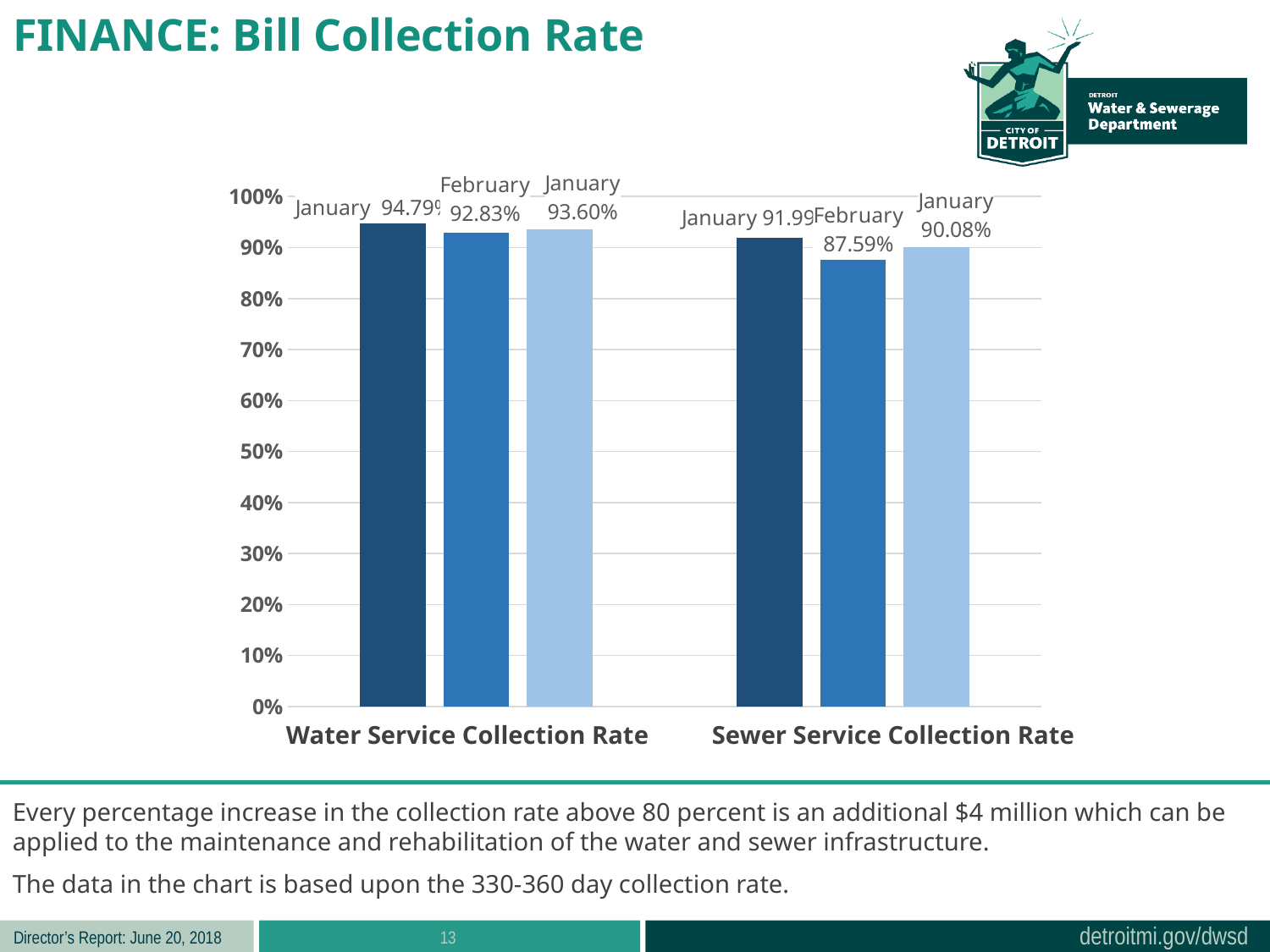
Is the February value for Sewer Service Collection Rate greater or less than 90%? less How many bars are plotted for each category? 3 Which has the higher February collection rate, Water Service or Sewer Service? Water Service Collection Rate What is the February value for Sewer Service Collection Rate? 87.59% What kind of chart is shown on the slide? bar chart What is the value of the rightmost (light blue) January bar for Sewer Service Collection Rate? 90.08% What is the difference between the February values for Water Service Collection Rate and Sewer Service Collection Rate? 5.24% How many categories are shown on the x axis of the chart? 2 What is the February value for Water Service Collection Rate? 92.83% Which bar shows the lowest collection rate on the chart? February for Sewer Service Collection Rate (87.59%) What is the difference between the rightmost January bars for Water Service Collection Rate and Sewer Service Collection Rate? 3.52% What is the value of the rightmost (light blue) January bar for Water Service Collection Rate? 93.60%